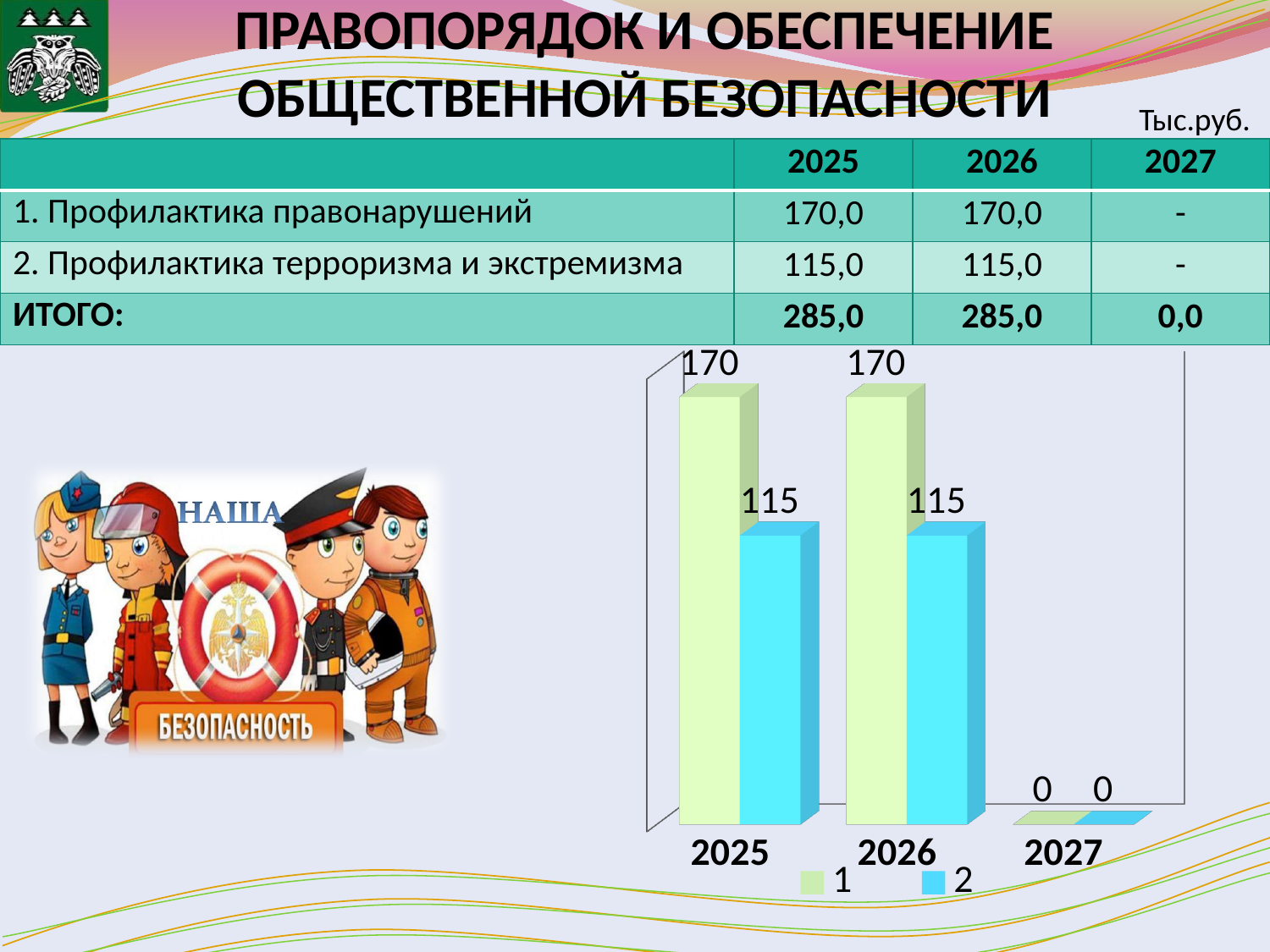
What is the value of series 1 for 2027 in the chart? 0 How many categories are shown on the x axis of the chart? 3 Does the value of series 1 rise or fall from 2026 to 2027 in the chart? fall Which is larger in the chart for 2026: series 1 or series 2? series 1 What is the value of series 2 for 2026 in the chart? 115 What type of chart is shown on the slide? bar chart What is the difference between series 1 and series 2 for 2025 in the chart? 55 What is the value of series 1 for 2025 in the chart? 170 Which category has the lowest value for series 2 in the chart? 2027 What colour are the bars for series 2 in the chart? blue How many series does the chart legend list? 2 What are the legend entries of the chart? 1 and 2